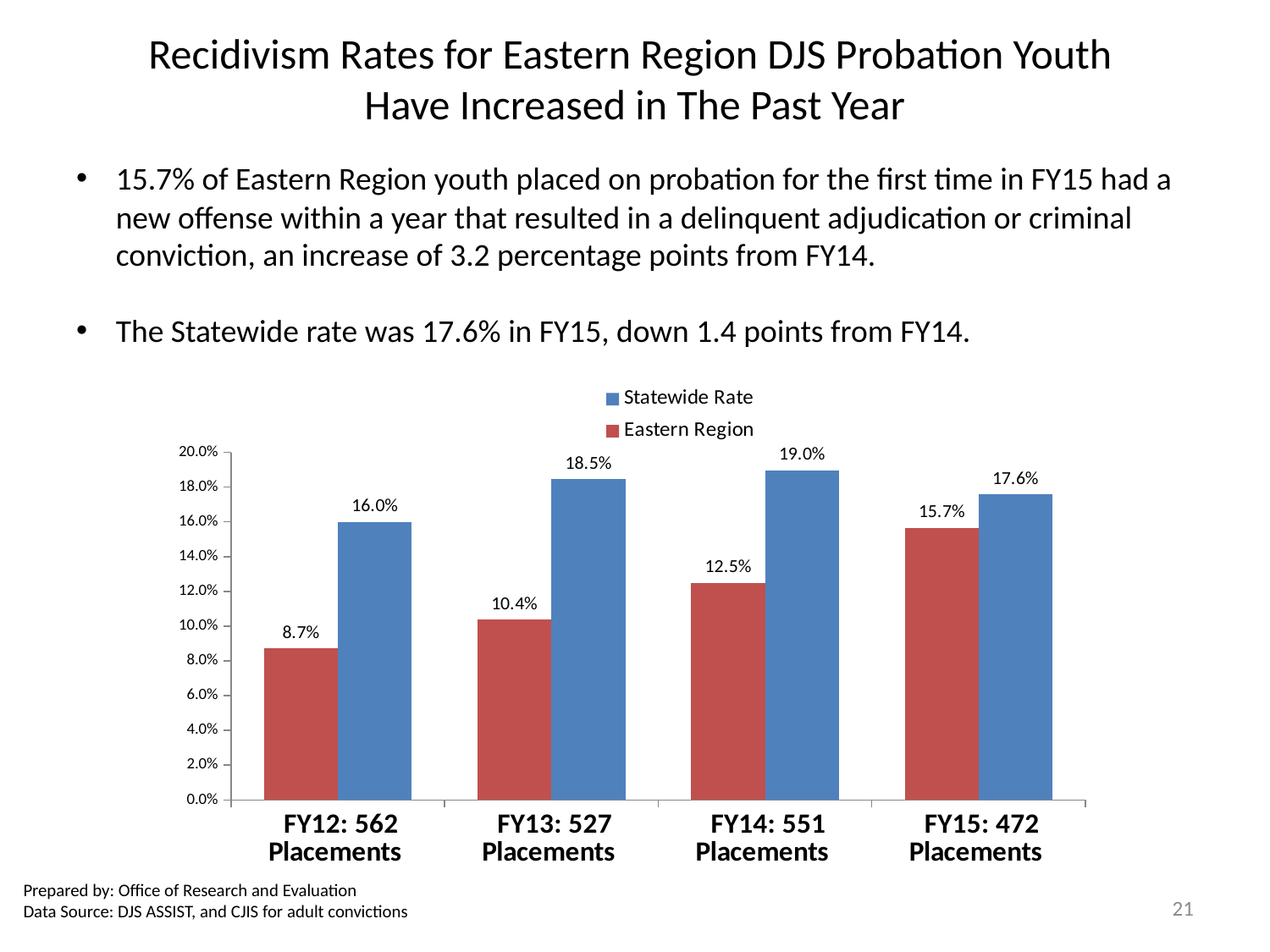
In which fiscal year is the Statewide Rate highest? FY14: 551 Placements What is the Eastern Region recidivism rate for FY15: 472 Placements? 15.7% Which is larger for FY15: 472 Placements, the Statewide Rate or the Eastern Region rate? Statewide Rate What is the difference between the Statewide Rate and the Eastern Region rate for FY13: 527 Placements? 8.1 percentage points In which fiscal year is the Eastern Region rate lowest? FY12: 562 Placements Is the Eastern Region rate for FY14: 551 Placements greater or less than 14.0%? less What is the Statewide Rate for FY14: 551 Placements? 19.0% What is the Eastern Region rate for FY12: 562 Placements? 8.7% How many fiscal year categories are shown on the x axis? 4 What kind of chart is shown on the slide? Bar chart Does the Eastern Region rate rise or fall from FY12 to FY15? Rise How many series does the legend list? 2